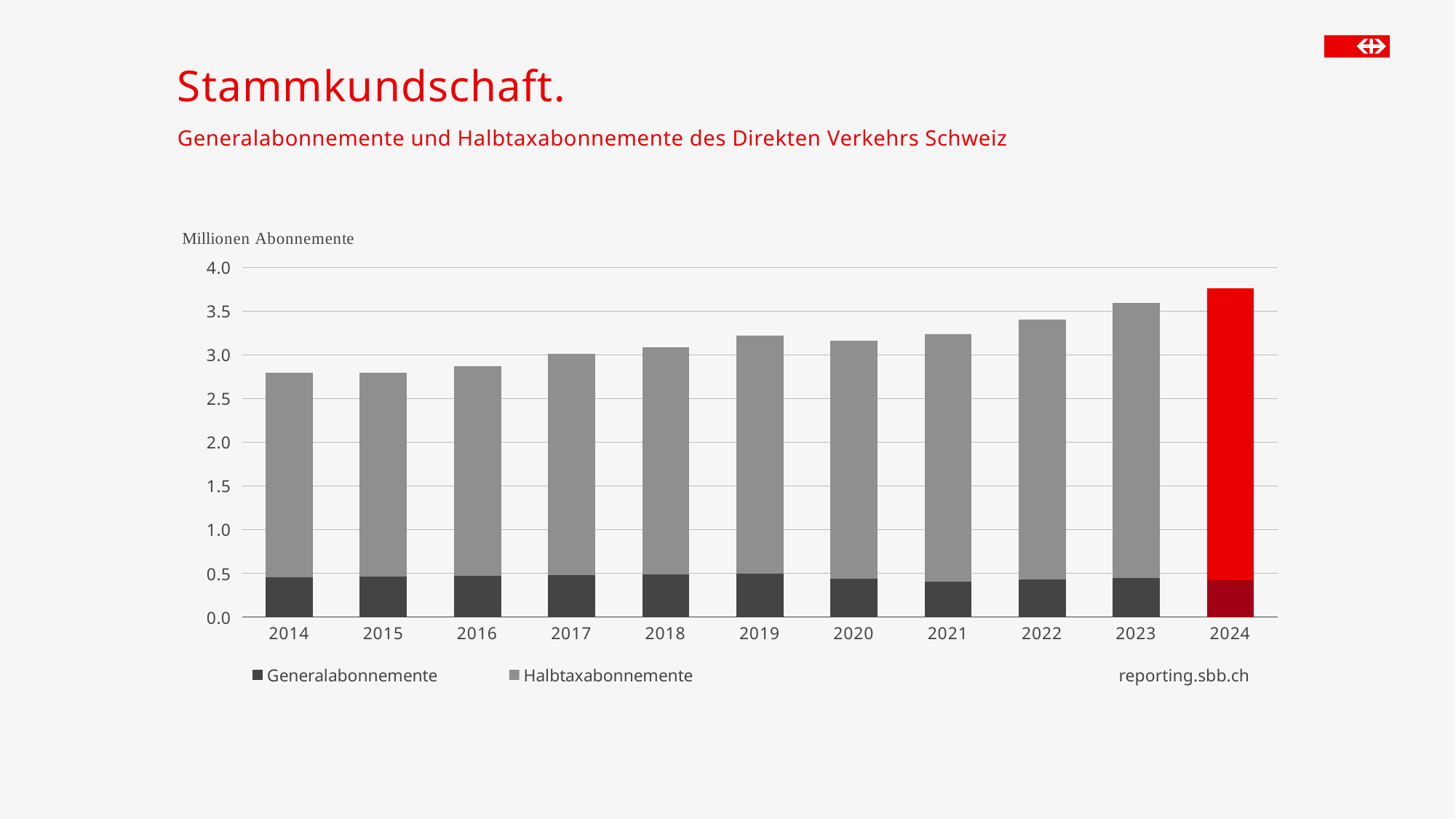
Is the total value for 2014 greater or less than 3.0? less What kind of chart is shown on the slide? Stacked bar chart Which year has the highest total number of subscriptions in the chart? 2024 How many series does the chart's legend list? 2 How many years are shown on the x axis of the chart? 11 Is the total value for 2019 greater or less than 3.0? greater Is the Generalabonnemente value for 2021 greater or less than 0.5? less What unit is given for the y axis of the chart? Millionen Abonnemente Which year has the larger total, 2020 or 2022? 2022 Which series is shown in the darker colour at the bottom of each bar? Generalabonnemente Do the total subscription values generally rise or fall from 2014 to 2024? Rise